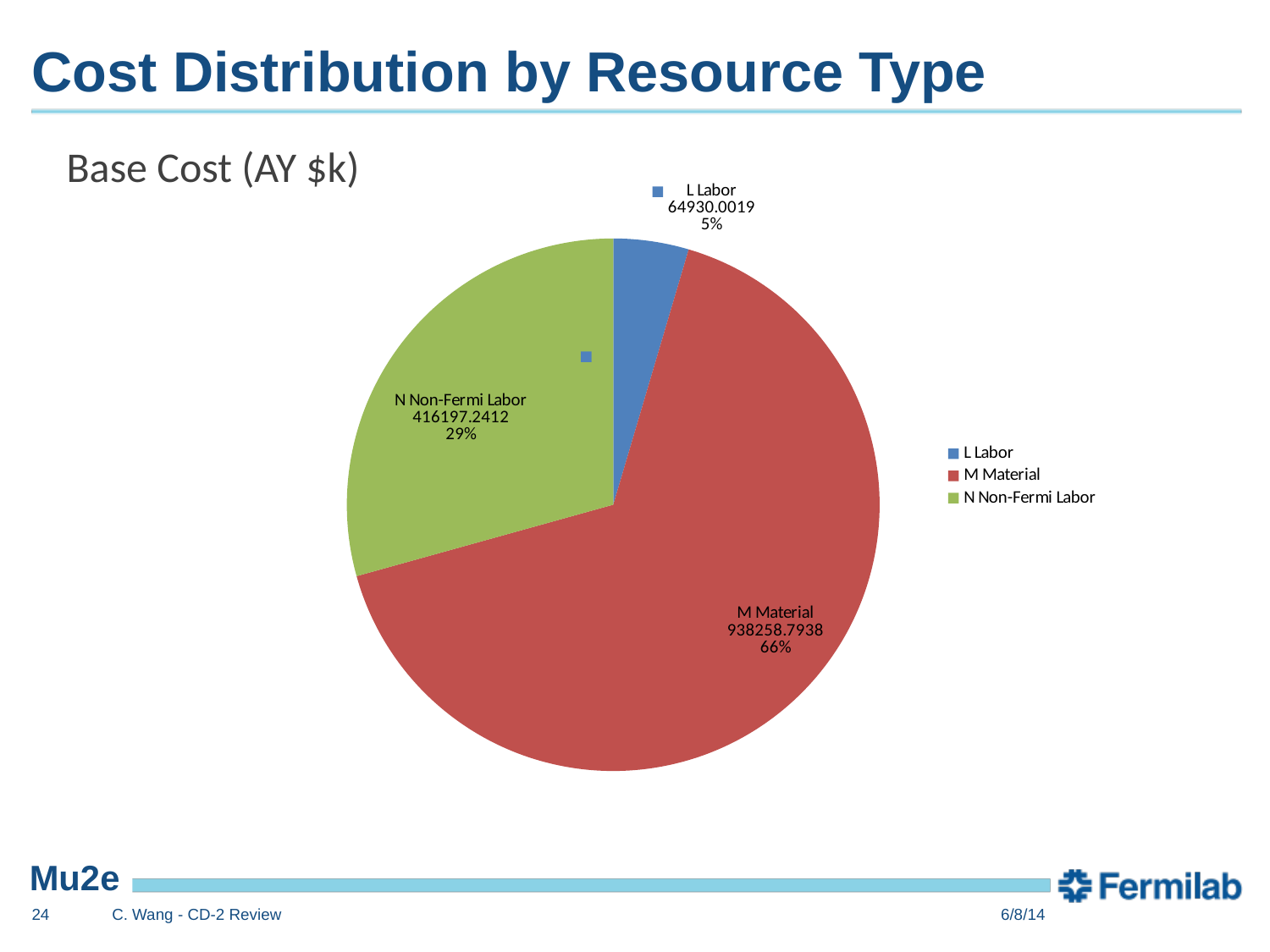
What percentage of the base cost is N Non-Fermi Labor? 29% What type of chart is shown on the slide? Pie chart What is the value for N Non-Fermi Labor in the pie chart? 416197.2412 What percentage of the base cost is L Labor? 5% Which is larger, the value for N Non-Fermi Labor or the value for L Labor? N Non-Fermi Labor What is the value for L Labor in the pie chart? 64930.0019 What is the difference between the M Material value and the N Non-Fermi Labor value? 522061.5526 Which resource type has the largest share of the base cost? M Material Which resource type has the smallest share of the base cost? L Labor What is the value for M Material in the pie chart? 938258.7938 How many slices does the pie chart have? 3 What percentage of the base cost is M Material? 66%